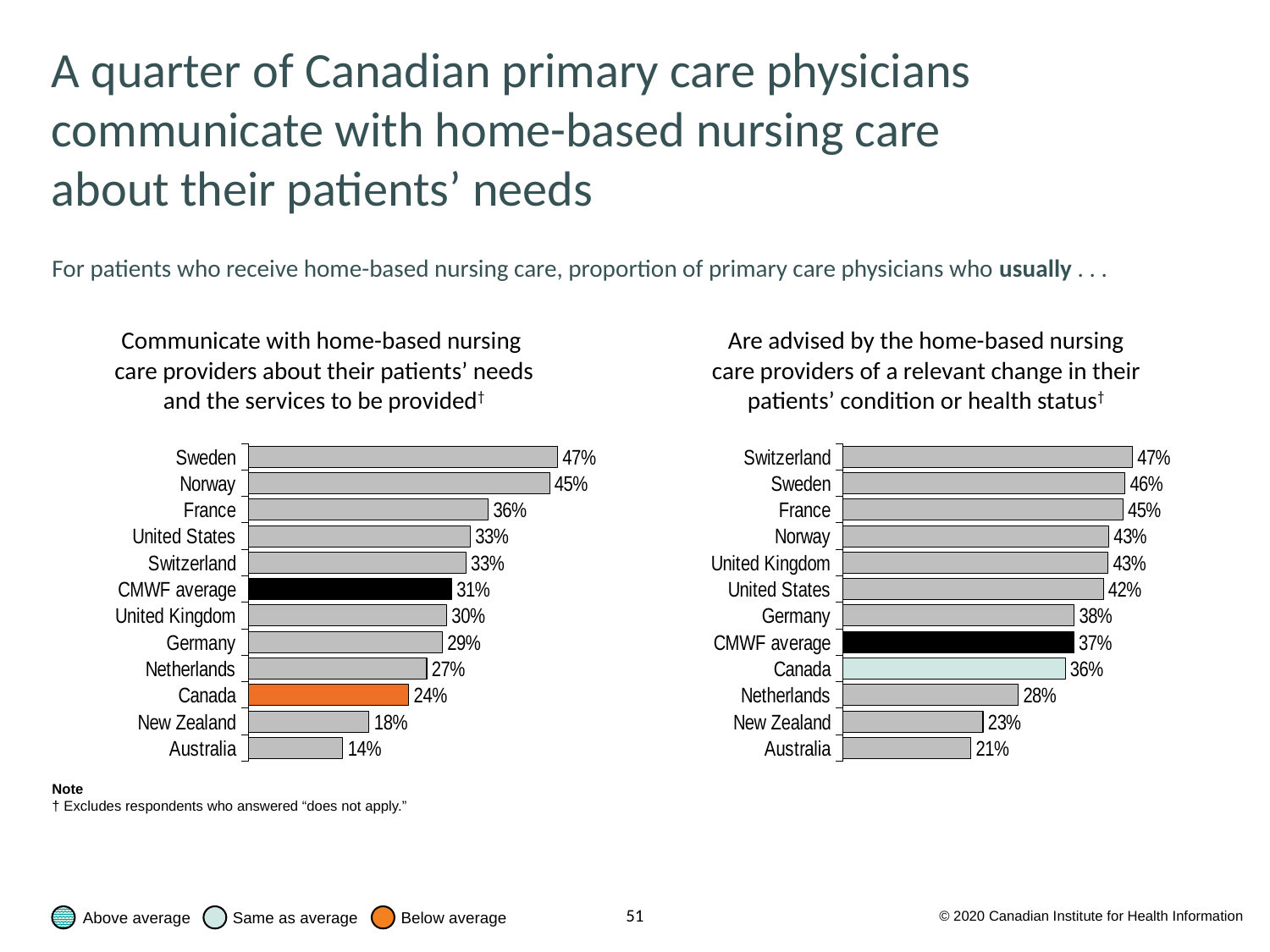
In the left chart (Communicate with home-based nursing care providers), what is the value for Canada? 24% What kind of chart is the right chart (Are advised by the home-based nursing care providers of a relevant change)? Bar chart In the left chart (Communicate with home-based nursing care providers), what colour is the bar for Canada? Orange In the left chart (Communicate with home-based nursing care providers), what is the difference between Sweden and Australia? 33 percentage points In the left chart (Communicate with home-based nursing care providers), what is the CMWF average value? 31% In the right chart (Are advised by the home-based nursing care providers of a relevant change), which country has the lowest value? Australia In the left chart (Communicate with home-based nursing care providers), which country has the highest value? Sweden In the right chart (Are advised by the home-based nursing care providers of a relevant change), what is the value for Germany? 38% In the left chart (Communicate with home-based nursing care providers), which is larger: the value for Norway or the value for France? Norway How many bars (countries plus the CMWF average) are shown in the left chart (Communicate with home-based nursing care providers)? 12 In the right chart (Are advised by the home-based nursing care providers of a relevant change), what is the difference between Canada and the CMWF average? 1 percentage point In the right chart (Are advised by the home-based nursing care providers of a relevant change), which is larger: the value for Netherlands or the value for New Zealand? Netherlands